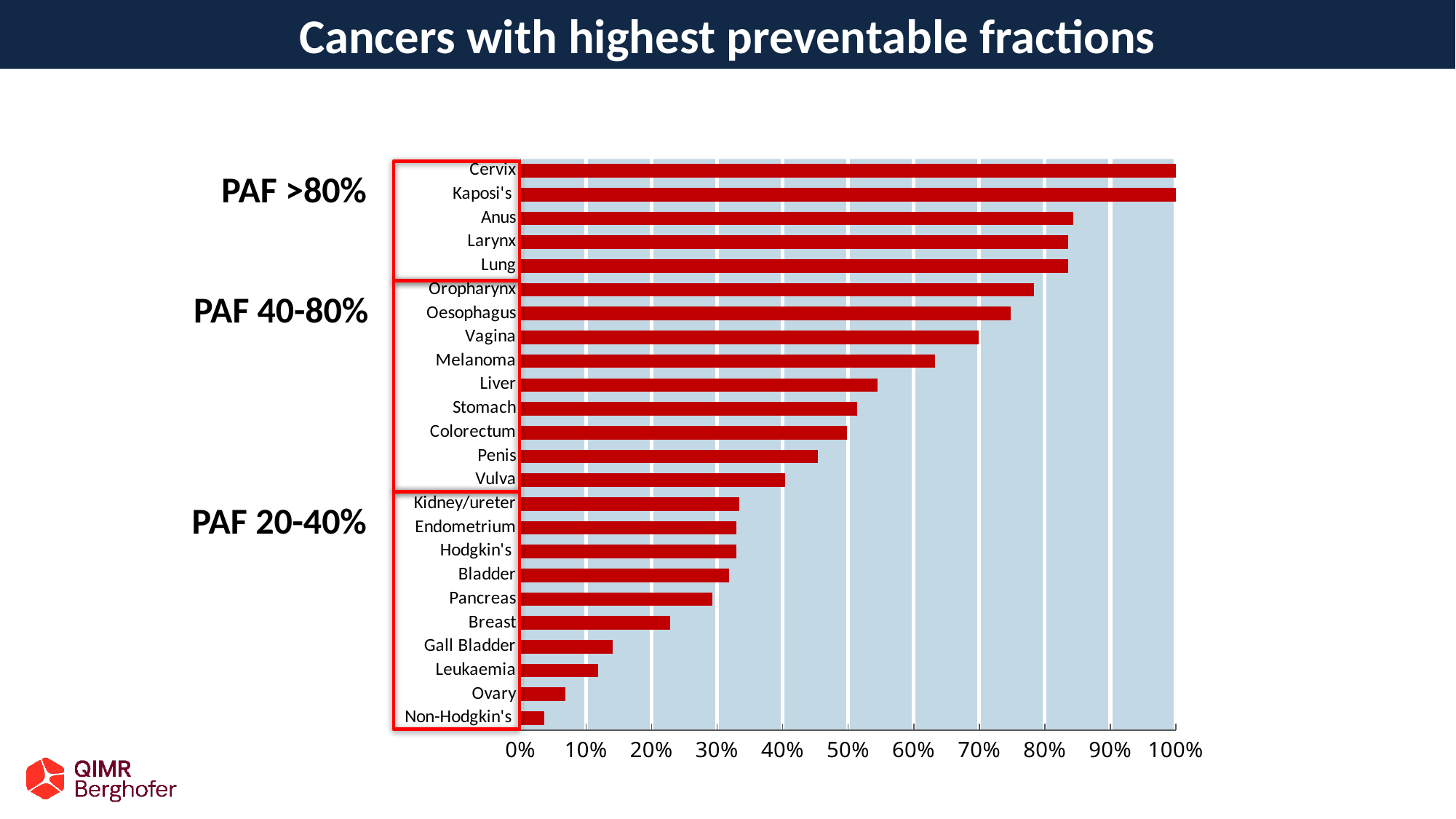
Which has the larger preventable fraction, Pancreas or Breast? Pancreas Which has the larger preventable fraction, Melanoma or Liver? Melanoma Which cancer type has the lowest preventable fraction in the chart? Non-Hodgkin's What is the preventable fraction shown for Cervix? 100% Is the value for Lung greater or less than 80%? greater What kind of chart is shown on the slide? bar chart Is the value for Breast greater or less than 30%? less How many cancer types are plotted in the chart? 24 What is the title of the slide's chart? Cancers with highest preventable fractions Is the value for Ovary greater or less than 10%? less Which PAF group label is shown next to the top group of bars (Cervix to Lung)? PAF >80%